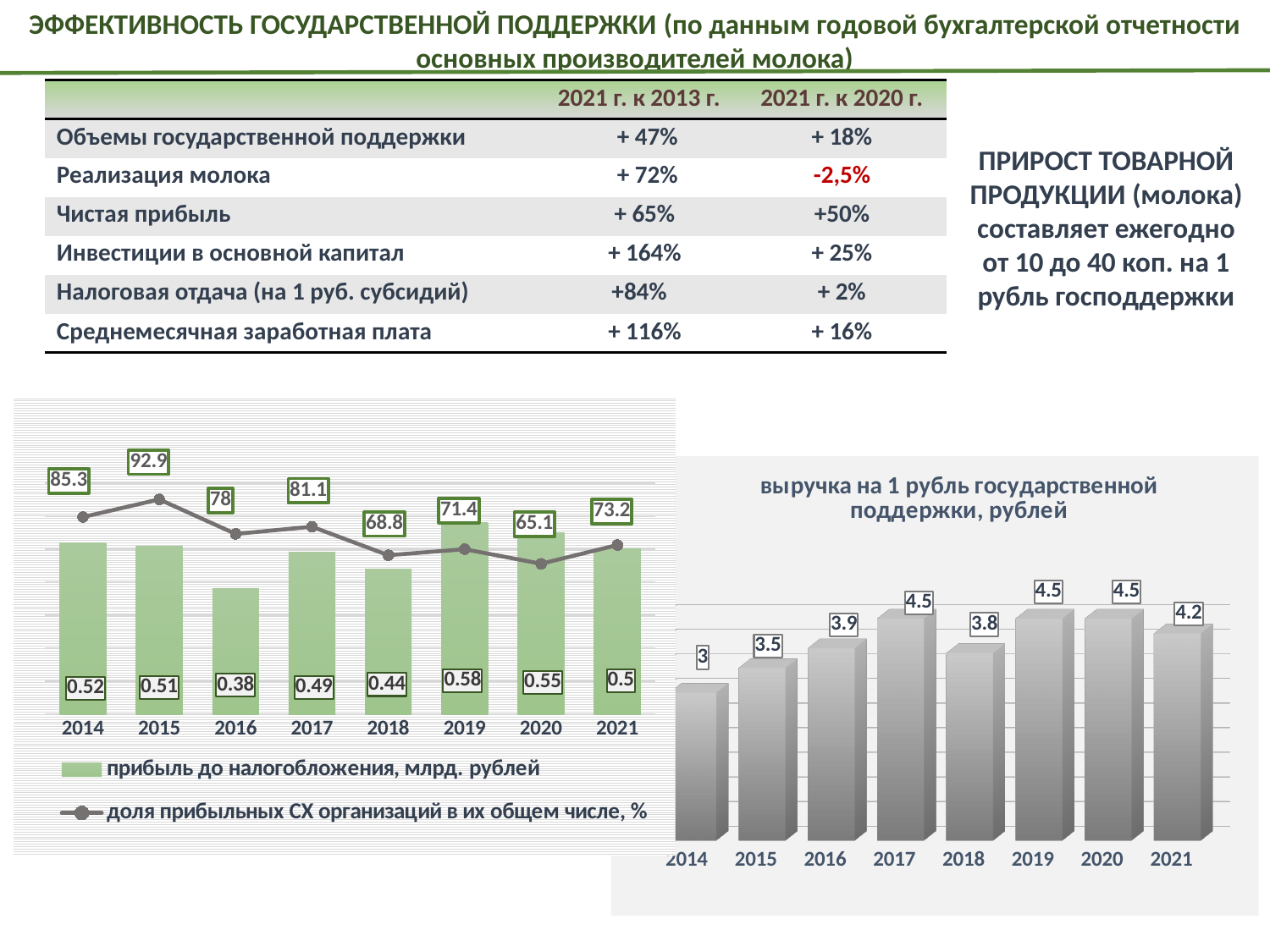
In the left chart, what is the value of 'доля прибыльных СХ организаций в их общем числе, %' for 2015? 92.9 In the chart 'выручка на 1 рубль государственной поддержки, рублей', which year has the lowest value? 2014 In the left chart, which year has the lowest value of 'прибыль до налогообложения, млрд. рублей'? 2016 In the left chart, which year has the highest value of 'доля прибыльных СХ организаций в их общем числе, %'? 2015 In the left chart, what is the value of 'прибыль до налогообложения, млрд. рублей' for 2019? 0.58 In the left chart, how many series does the legend list? 2 In the chart 'выручка на 1 рубль государственной поддержки, рублей', how many years are shown on the x axis? 8 In the chart 'выручка на 1 рубль государственной поддержки, рублей', what is the value for 2018? 3.8 In the left chart, is the 'прибыль до налогообложения' value for 2021 larger or smaller than for 2020? smaller In the left chart, what is the difference between the 'доля прибыльных СХ организаций' values for 2015 and 2020? 27.8 In the chart 'выручка на 1 рубль государственной поддержки, рублей', what is the difference between the values for 2017 and 2014? 1.5 What kind of chart is the chart 'выручка на 1 рубль государственной поддержки, рублей'? bar chart